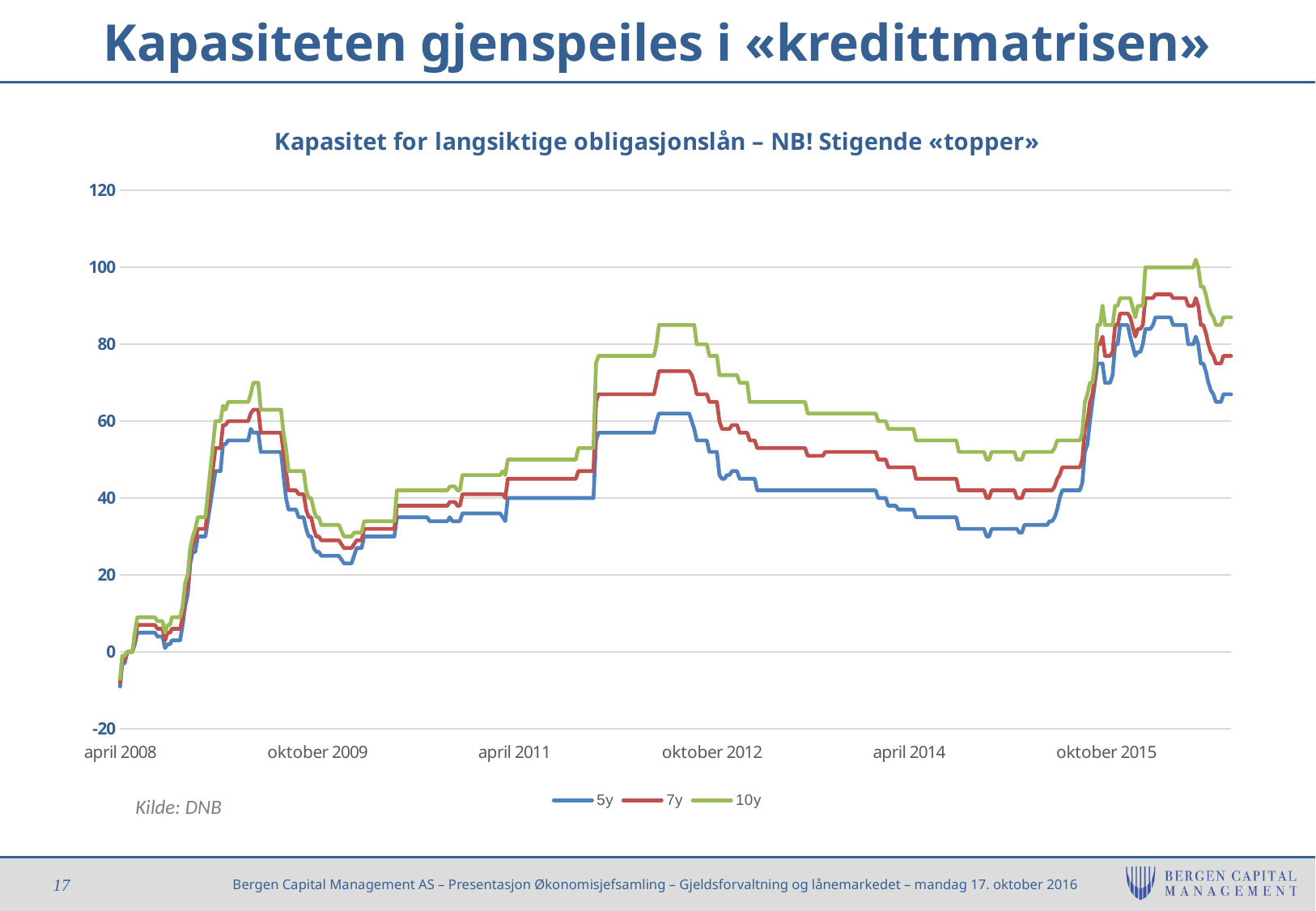
How many date labels are shown on the x axis? 6 What are the series names listed in the legend? 5y, 7y, 10y Is the value of the 10y series at april 2014 greater or less than 50? greater Which series has the highest value at april 2014? 10y How many series does the legend list? 3 Does the 10y series rise or fall between oktober 2012 and april 2014? fall What is the title of the chart? Kapasitet for langsiktige obligasjonslån – NB! Stigende «topper» Is the value of the 5y series at april 2014 greater or less than 40? less What kind of chart is shown on the slide? line chart Which series reaches the highest value anywhere on the chart? 10y Is the highest value reached by the 10y series greater or less than 80? greater